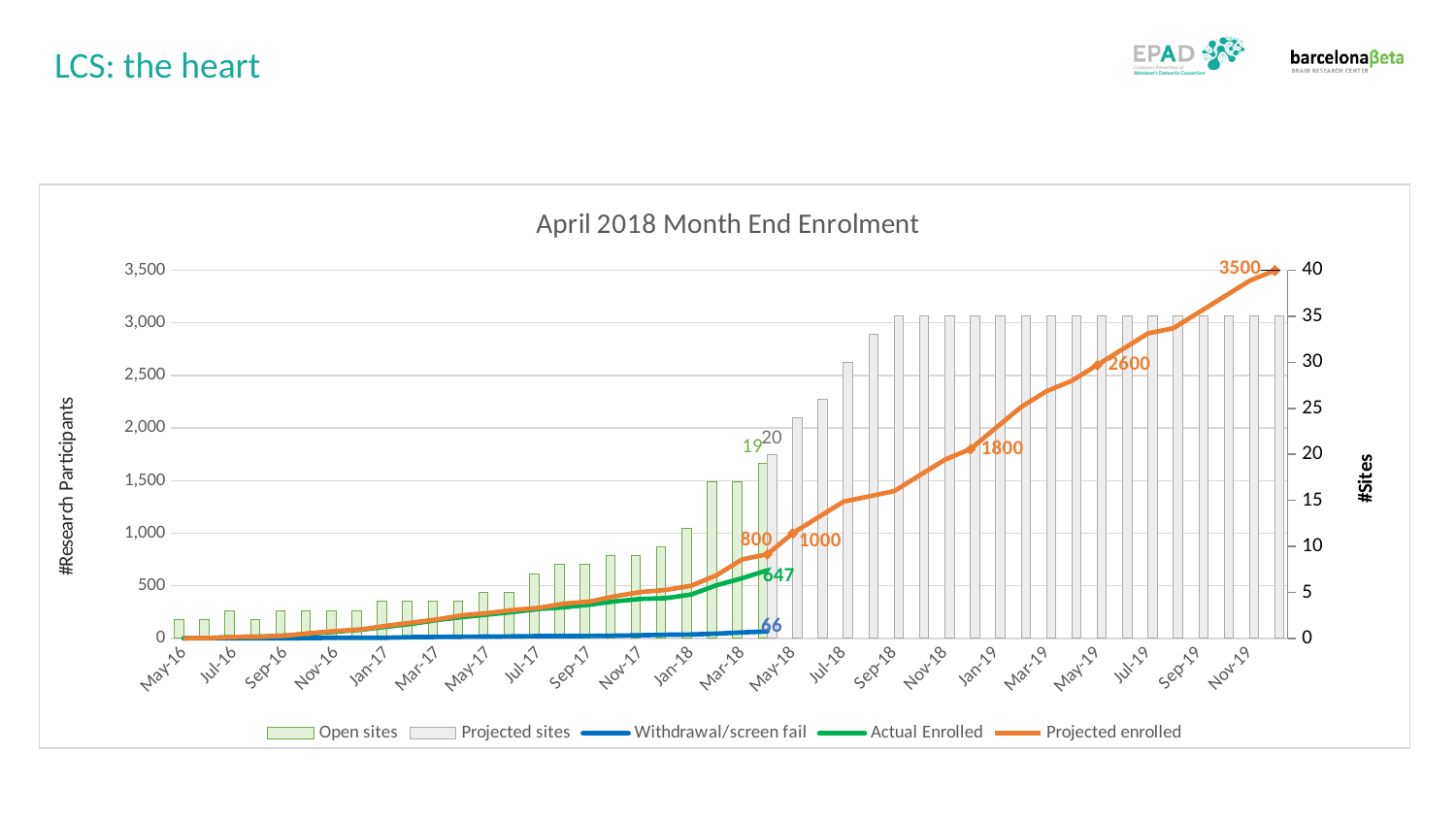
What kind of chart is shown on the slide? Combined bar and line chart What is the labelled value of the Withdrawal/screen fail line? 66 Does the Projected enrolled line rise or fall from May-16 to Nov-19? Rise What is the title of the chart? April 2018 Month End Enrolment What is the final labelled value of the Projected enrolled line? 3500 Is the Projected sites value at Nov-19 greater or less than 30 on the #Sites axis? greater How many series does the chart legend list? 5 What is the labelled value of the Projected enrolled line at May-19? 2600 What is the labelled value of the Actual Enrolled line? 647 Which is larger, the labelled Actual Enrolled value or the labelled Withdrawal/screen fail value? Actual Enrolled What is the difference between the final Projected enrolled value (3500) and the May-19 Projected enrolled value (2600)? 900